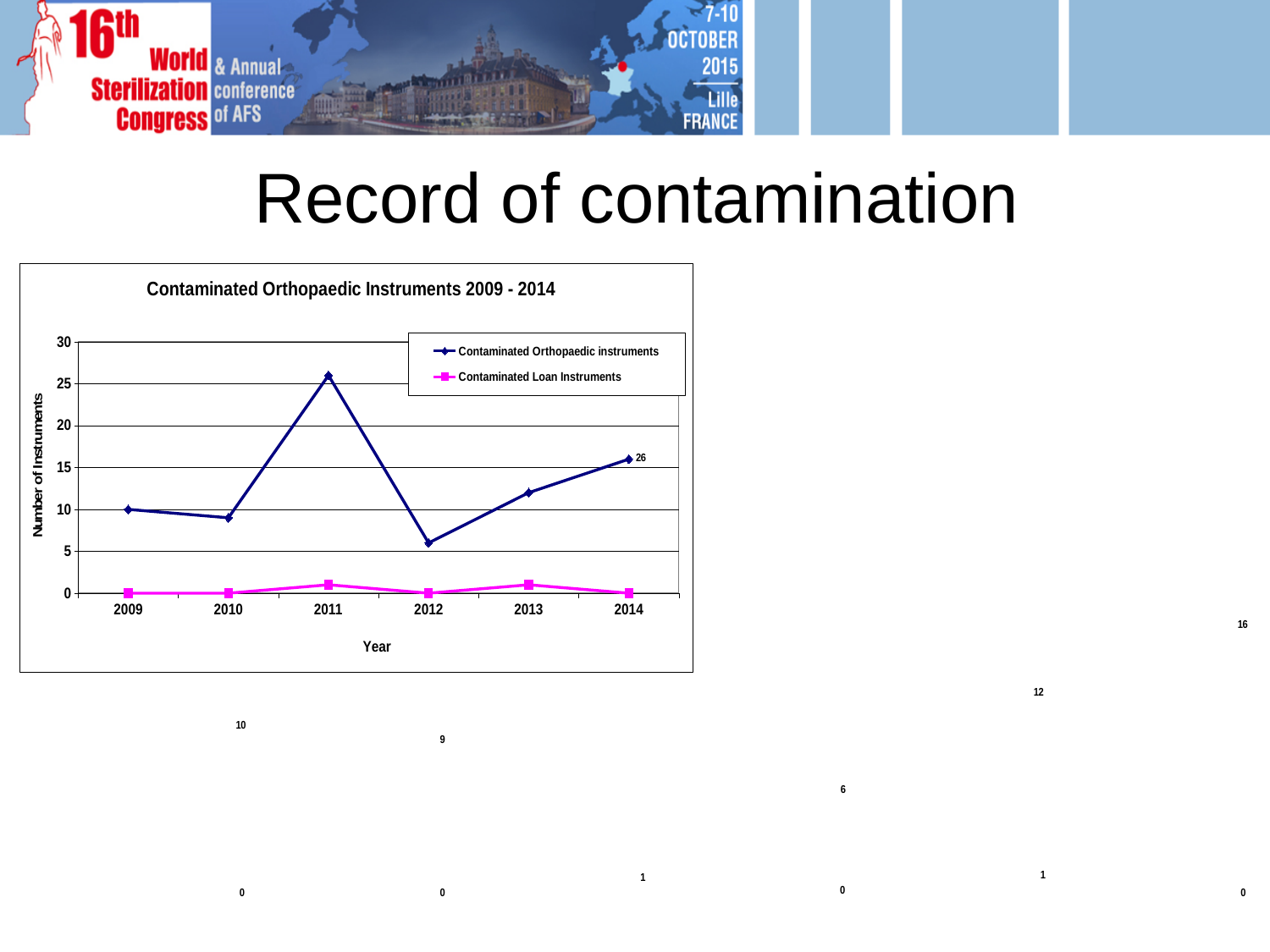
Is the value for Contaminated Orthopaedic instruments in 2011 greater or less than 25? greater How many series does the legend list? 2 In which year is the number of Contaminated Orthopaedic instruments lowest? 2012 What kind of chart is shown on the slide? line chart What is the value for Contaminated Loan Instruments in 2009? 0 What is the title of the chart? Contaminated Orthopaedic Instruments 2009 - 2014 What is the value for Contaminated Orthopaedic instruments in 2009? 10 In which year is the number of Contaminated Orthopaedic instruments highest? 2011 Which year has more Contaminated Orthopaedic instruments, 2013 or 2014? 2014 How many years are plotted along the x axis? 6 Is the value for Contaminated Orthopaedic instruments in 2012 greater or less than 10? less Does the Contaminated Orthopaedic instruments line rise or fall from 2011 to 2012? fall